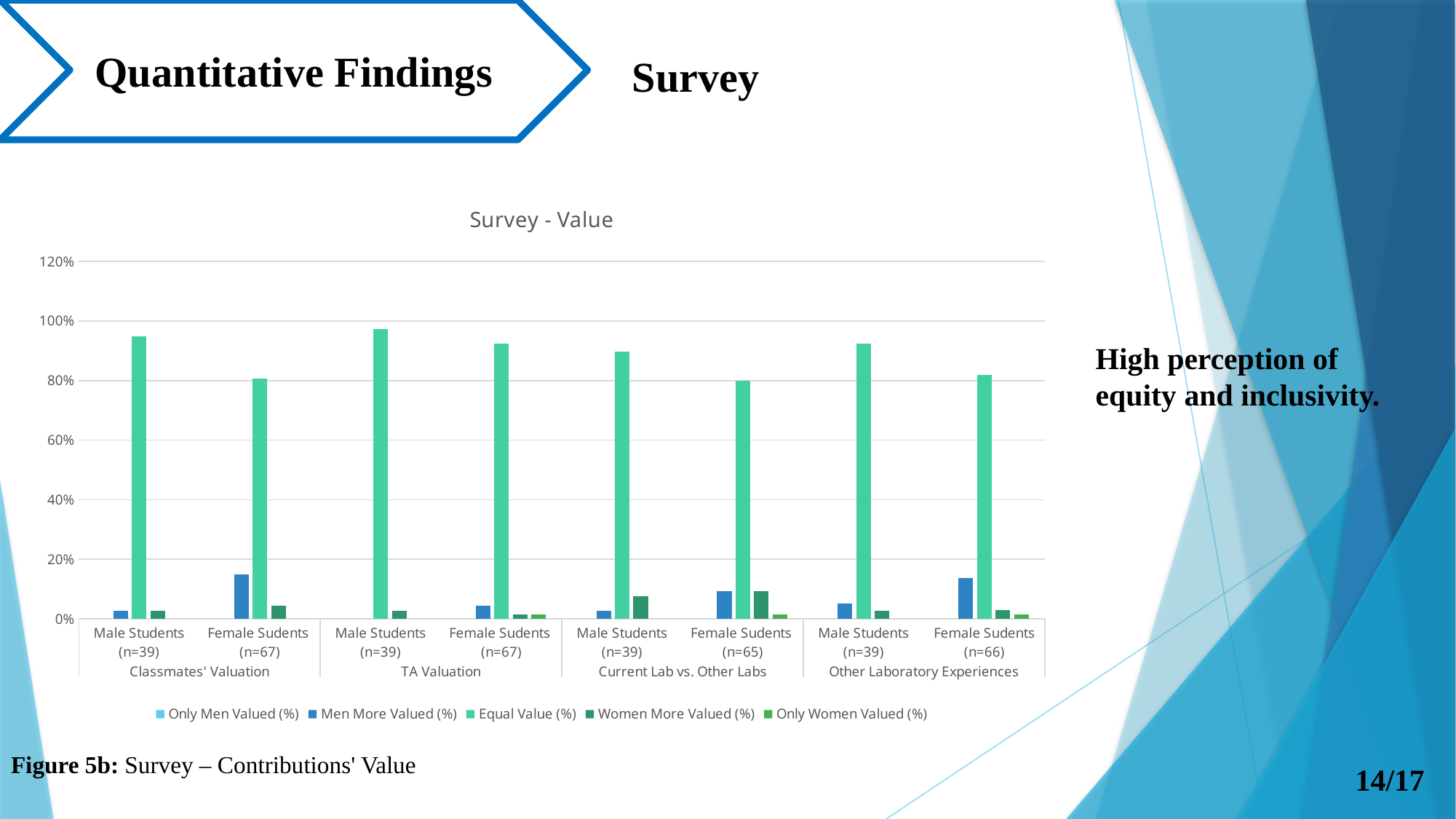
Under Classmates' Valuation, which group has the larger Equal Value (%): Male Students (n=39) or Female Students (n=67)? Male Students (n=39) For Male Students (n=39), is the Women More Valued (%) larger under Current Lab vs. Other Labs or under Classmates' Valuation? Current Lab vs. Other Labs What type of chart is shown on the slide? bar chart Is the Men More Valued (%) for Female Students (n=67) under Classmates' Valuation greater or less than 20%? less What is the title of the chart on the slide? Survey - Value Is the Equal Value (%) for Male Students (n=39) under Classmates' Valuation greater or less than 80%? greater How many series does the legend of the 'Survey - Value' chart list? 5 How many valuation categories (e.g. Classmates' Valuation, TA Valuation) are shown along the x axis? 4 Under Classmates' Valuation, which group has the larger Men More Valued (%): Male Students (n=39) or Female Students (n=67)? Female Students (n=67) Is the Equal Value (%) for Female Students (n=65) under Current Lab vs. Other Labs greater or less than 100%? less How many student groups (Male/Female Students) are shown along the x axis of the chart? 8